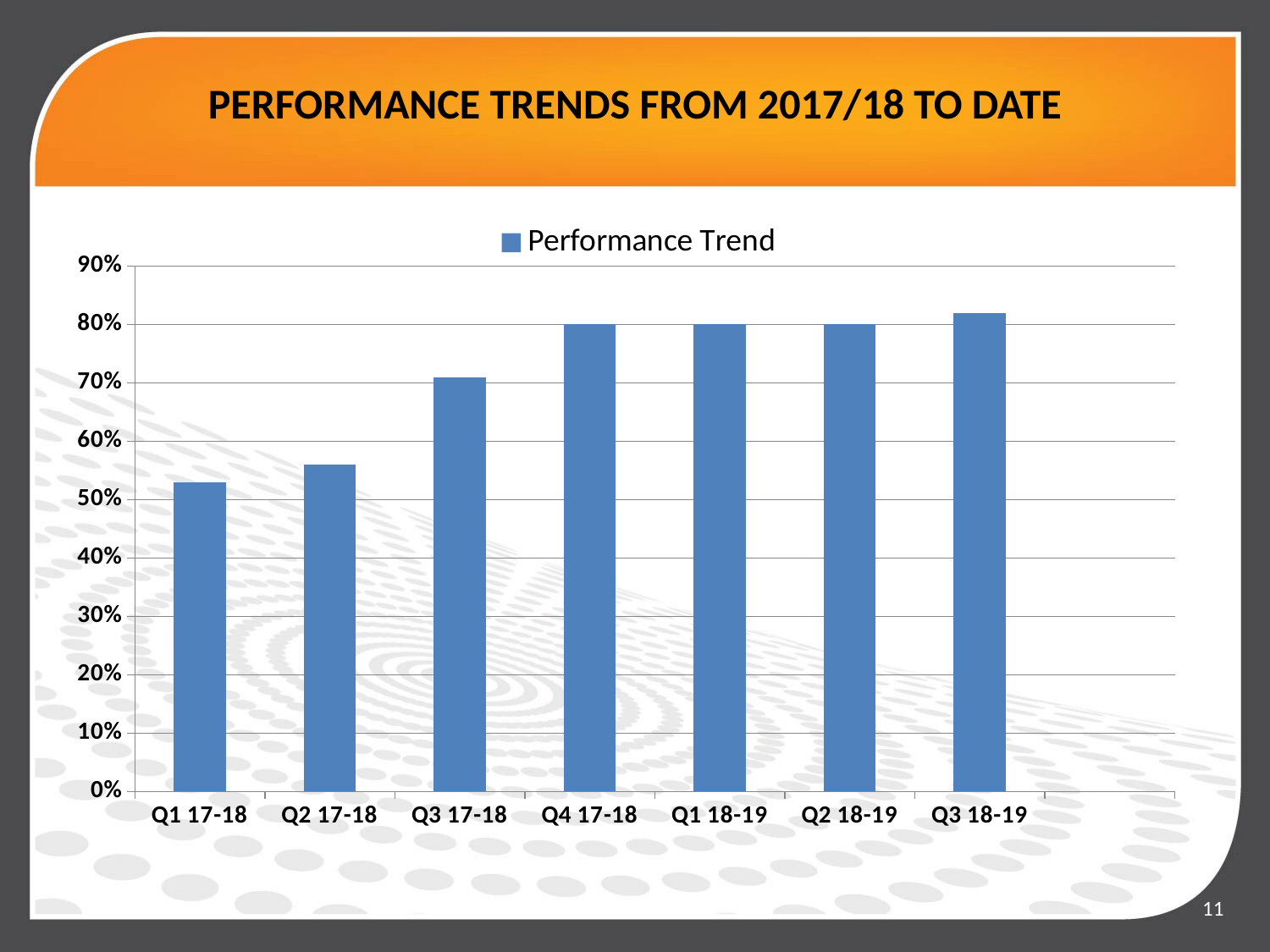
How many quarters are plotted on the x axis of the chart? 7 Which quarter has the lowest value in the chart? Q1 17-18 What is the name of the series shown in the chart legend? Performance Trend Is the value for Q3 17-18 greater or less than 60%? greater How many series does the chart legend list? 1 Which quarter has the highest value in the chart? Q3 18-19 What is the title of the slide containing the chart? PERFORMANCE TRENDS FROM 2017/18 TO DATE Which is larger, the value for Q2 17-18 or the value for Q3 17-18? Q3 17-18 Is the value for Q3 18-19 greater or less than 80%? greater Is the value for Q1 17-18 greater or less than 60%? less What kind of chart is shown on the slide? bar chart Do the values generally rise or fall from Q1 17-18 to Q3 18-19? rise